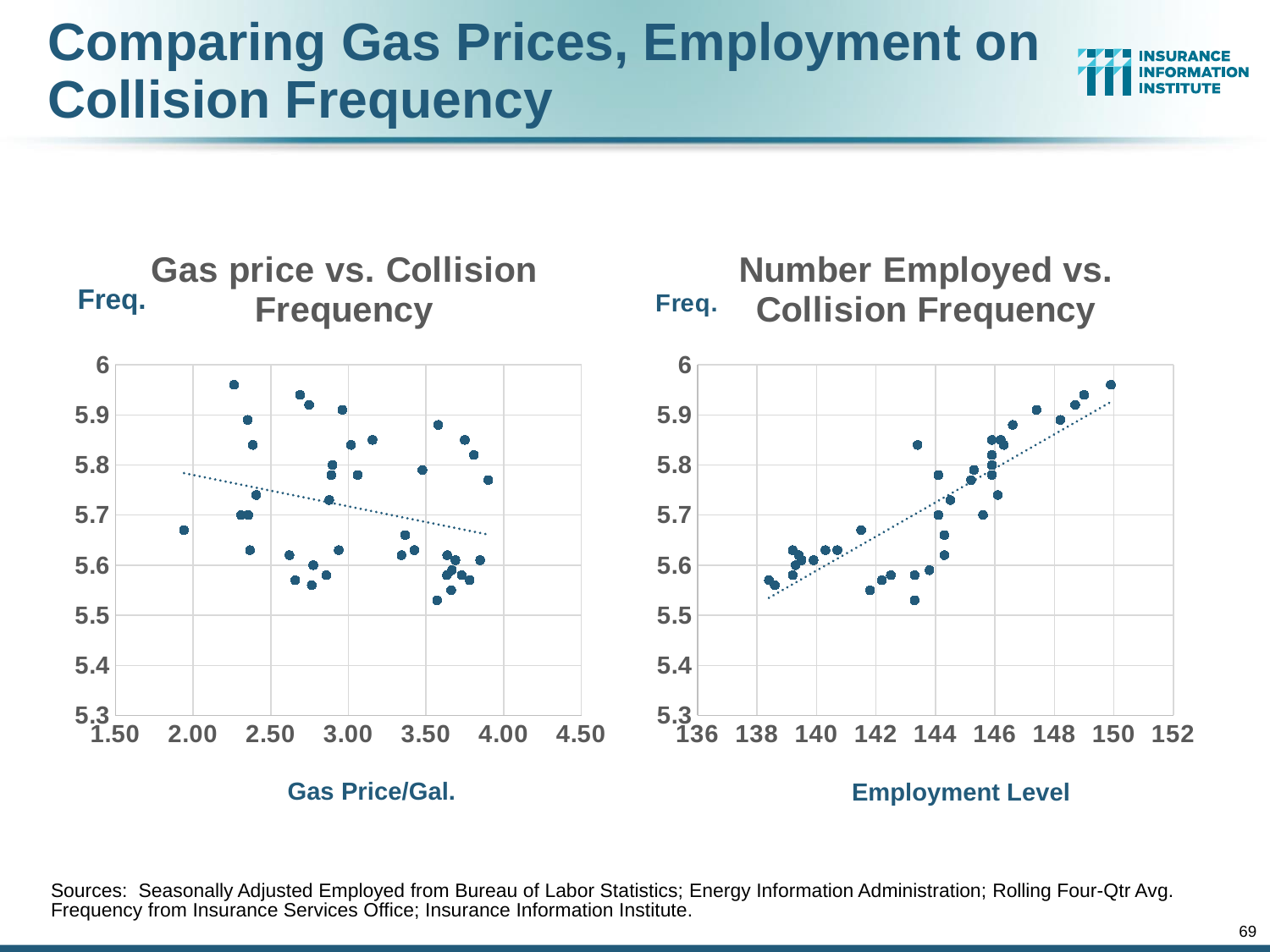
What kind of chart is the right chart titled "Number Employed vs. Collision Frequency"? scatter chart In the left chart, "Gas price vs. Collision Frequency", is the collision frequency at the lowest gas price (about 1.90) greater or less than 5.6? greater In the right chart, "Number Employed vs. Collision Frequency", does the dotted trend line rise or fall as employment level increases along the x axis? rise What kind of chart is the left chart titled "Gas price vs. Collision Frequency"? scatter chart In the right chart, "Number Employed vs. Collision Frequency", is the collision frequency at the lowest employment level (about 138.5) greater or less than 5.6? less In the right chart, "Number Employed vs. Collision Frequency", is the collision frequency at the highest employment level (about 150) greater or less than 5.9? greater What is the x-axis title of the right chart, "Number Employed vs. Collision Frequency"? Employment Level What is the x-axis title of the left chart, "Gas price vs. Collision Frequency"? Gas Price/Gal. In the left chart, "Gas price vs. Collision Frequency", does the dotted trend line rise or fall as gas price increases along the x axis? fall